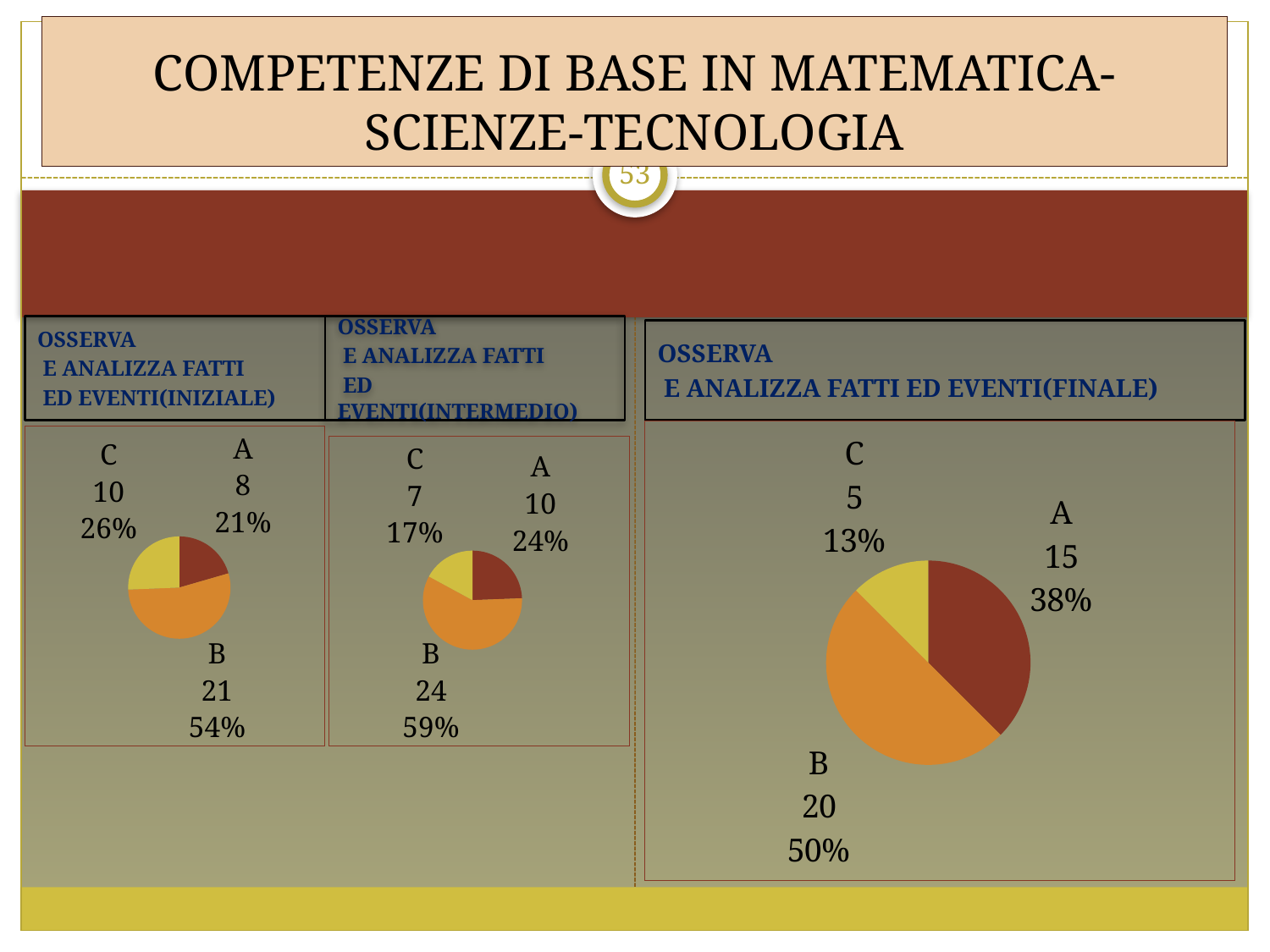
How many pie charts are shown on the slide? 3 In the OSSERVA E ANALIZZA FATTI ED EVENTI(FINALE) chart, what percentage share does A have? 38% In the OSSERVA E ANALIZZA FATTI ED EVENTI(INIZIALE) chart, which is larger, the value for A or the value for C? C In the OSSERVA E ANALIZZA FATTI ED EVENTI(INTERMEDIO) chart, which category has the smallest slice? C In the OSSERVA E ANALIZZA FATTI ED EVENTI(FINALE) chart, what is the difference between the values for B and A? 5 In the OSSERVA E ANALIZZA FATTI ED EVENTI(INIZIALE) chart, what percentage share does C have? 26% In the OSSERVA E ANALIZZA FATTI ED EVENTI(FINALE) chart, what is the value for C? 5 In the OSSERVA E ANALIZZA FATTI ED EVENTI(INTERMEDIO) chart, what is the value for A? 10 In the OSSERVA E ANALIZZA FATTI ED EVENTI(INIZIALE) chart, what is the value for B? 21 How many categories does the OSSERVA E ANALIZZA FATTI ED EVENTI(FINALE) chart show? 3 What kind of chart is the OSSERVA E ANALIZZA FATTI ED EVENTI(FINALE) chart? Pie chart In the OSSERVA E ANALIZZA FATTI ED EVENTI(INTERMEDIO) chart, which category has the largest slice? B